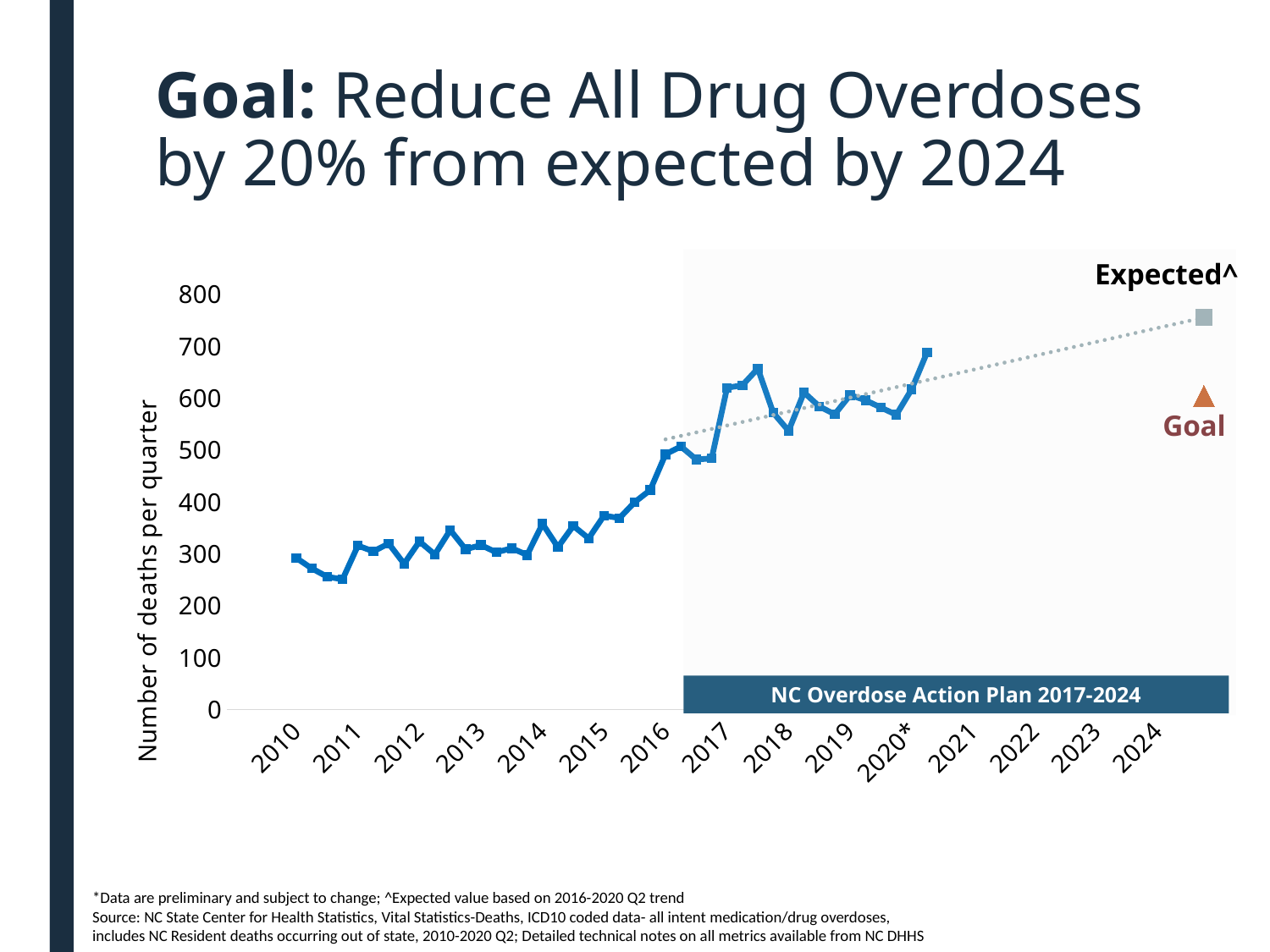
Is the first plotted value of the blue line, at 2010, greater or less than 200? greater What is the label on the vertical axis of the chart? Number of deaths per quarter Around which year does the blue line reach its lowest value? 2011 Which is larger: the first plotted value at 2010 or the last plotted value at 2020*? 2020* Is the Goal marker plotted at 2024 greater or less than 700? less Is the last plotted value of the blue line (2020*) greater or less than 600? greater What text appears in the dark banner along the bottom of the shaded area of the chart? NC Overdose Action Plan 2017-2024 How many year labels are shown along the x axis of the chart? 15 What kind of chart is shown on the slide? line chart Overall, do the plotted number of deaths per quarter rise or fall from 2010 to 2020? rise